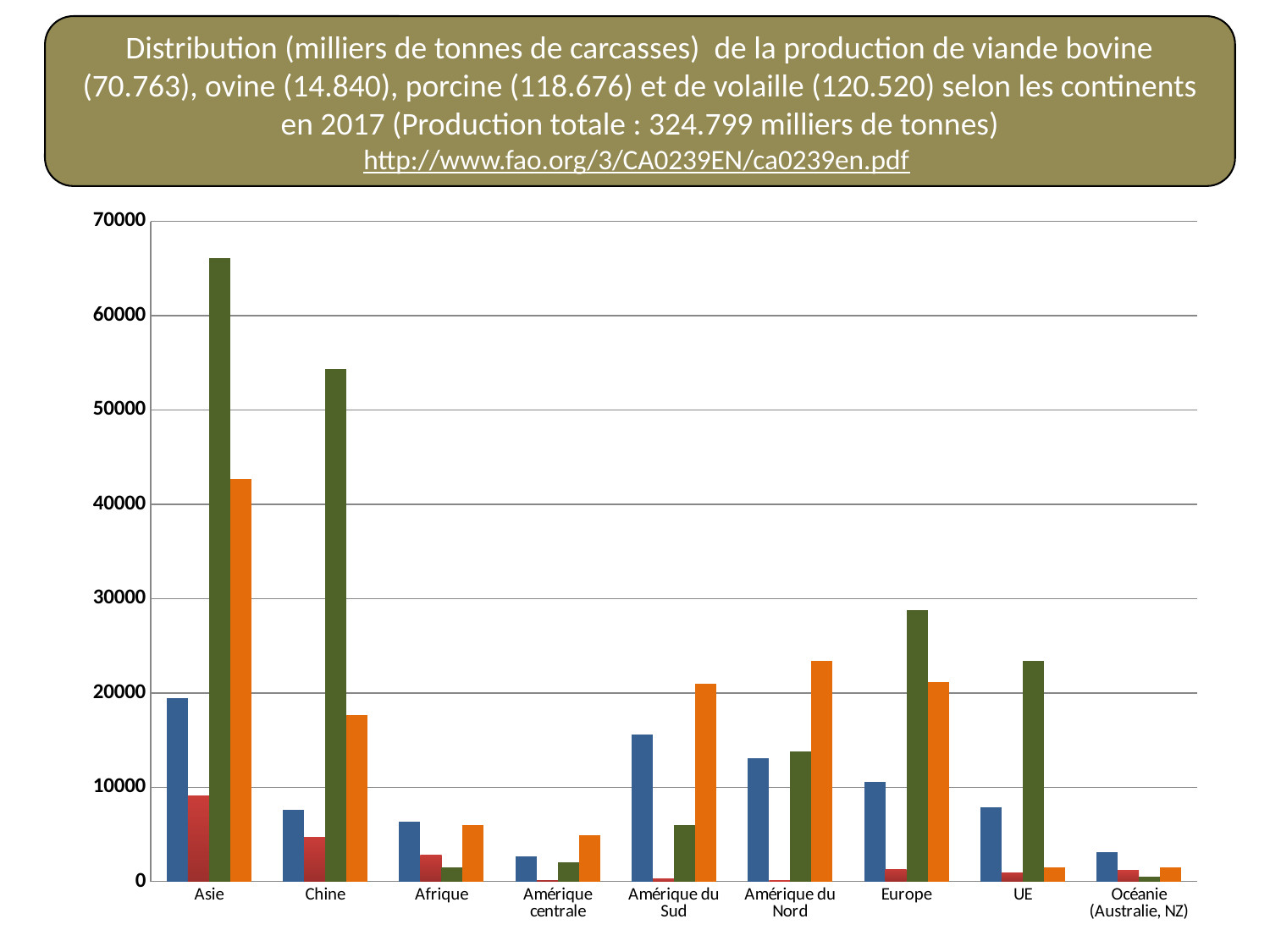
Which has the larger dark green bar, Chine or Europe? Chine How many categories are shown along the x axis of the chart? 9 How many bars (series) are plotted for each category in the chart? 4 Which category has the shortest dark green bar? Océanie (Australie, NZ) What is the highest value shown on the y axis of the chart? 70000 Is the dark green bar for Asie greater or less than 60000? greater Which category has the tallest orange bar? Asie Is the dark green bar for Chine greater or less than 50000? greater Is the blue bar for Afrique greater or less than 10000? less What kind of chart is shown on the slide? bar chart Which category has the tallest dark green bar? Asie